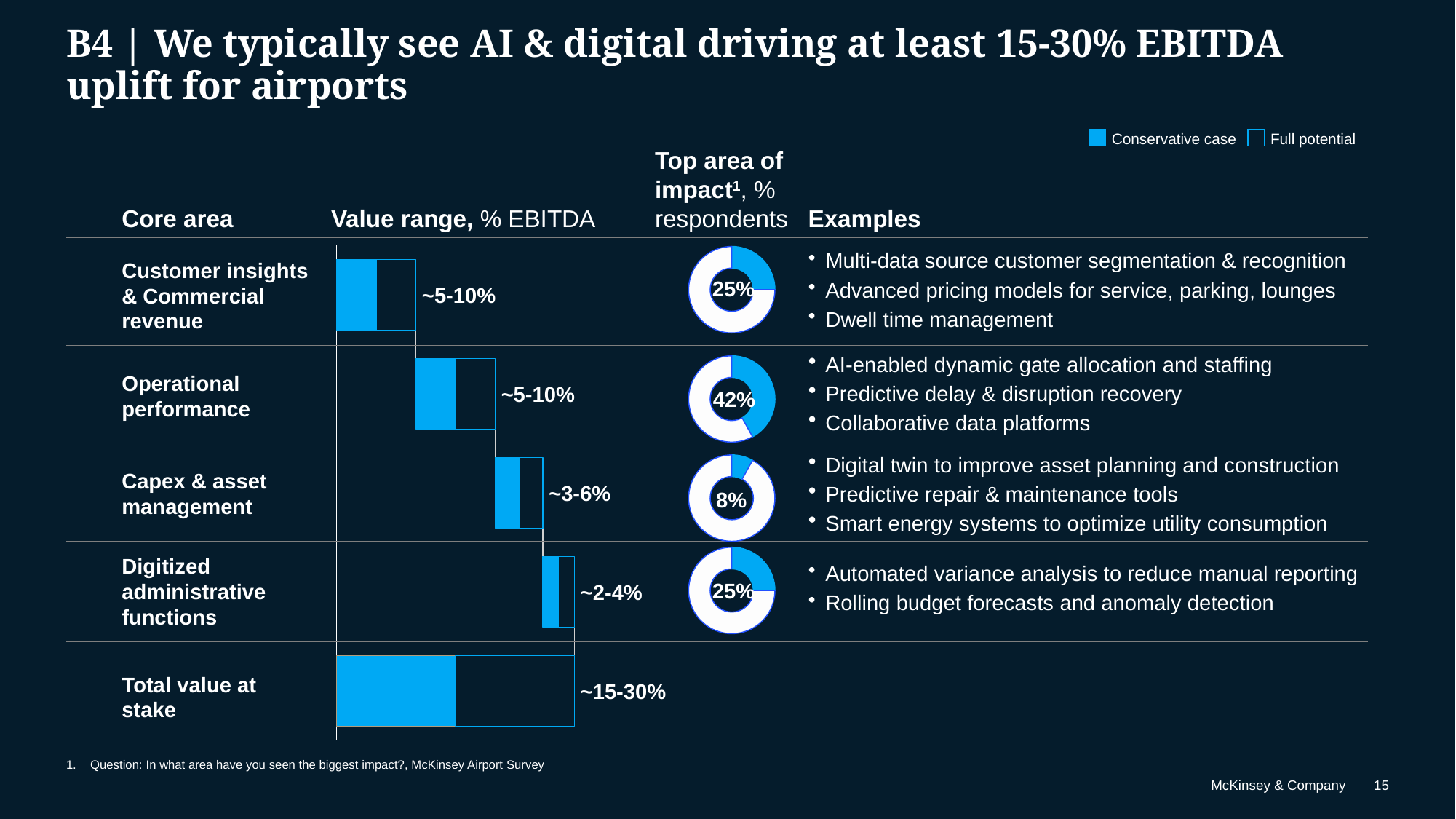
How many series does the legend at the top right of the slide list? 2 In the Top area of impact donut charts, which has a larger share of respondents: Customer insights & Commercial revenue or Capex & asset management? Customer insights & Commercial revenue In the Top area of impact donut charts, what percentage of respondents is shown for Operational performance? 42% In the Top area of impact donut charts, what is the difference in percentage points between Operational performance and Capex & asset management? 34 percentage points In the Top area of impact donut charts, which core area has the lowest share of respondents? Capex & asset management In the Value range chart, what is the value range shown for Total value at stake? ~15-30% In the Value range chart, what is the value range shown for Digitized administrative functions? ~2-4% In the Top area of impact donut charts, what percentage of respondents is shown for Capex & asset management? 8% What are the two legend entries shown at the top right of the slide? Conservative case and Full potential How many donut charts are shown in the Top area of impact column? 4 In the Value range chart, what is the value range shown for Operational performance? ~5-10% In the Top area of impact donut charts, which core area has the highest share of respondents? Operational performance